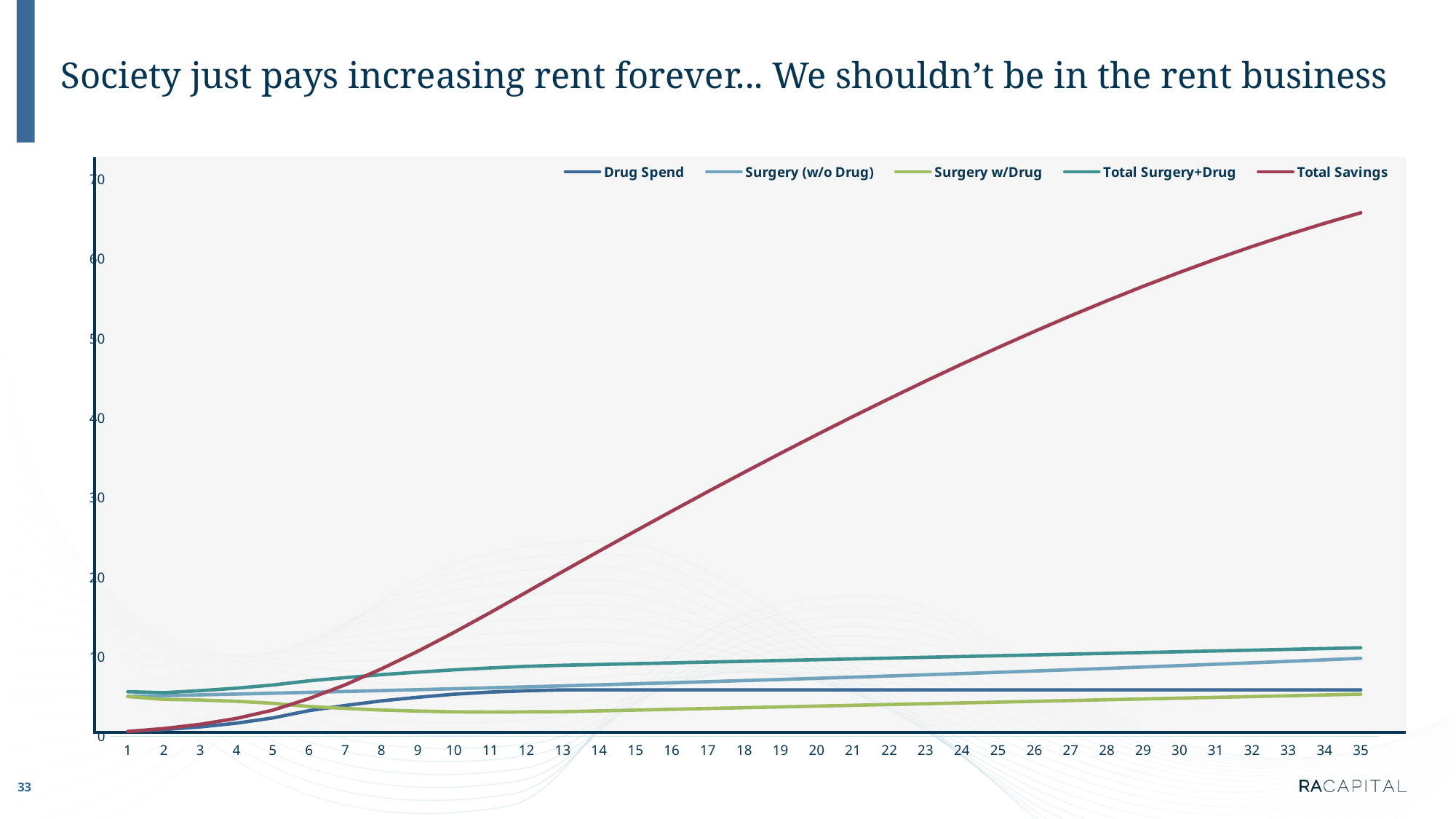
Is the value of Total Savings at point 10 greater or less than 20? less How many points are on the x axis of the chart? 35 Which series has the highest value at point 35? Total Savings How many series does the legend list? 5 At point 35, which is larger: Total Surgery+Drug or Surgery w/Drug? Total Surgery+Drug Is the value of Drug Spend at point 35 greater or less than 10? less What kind of chart is shown on the slide? line chart Does the Total Savings line rise or fall along the x axis? rises At point 20, which is larger: Total Savings or Surgery (w/o Drug)? Total Savings Is the value of Total Savings at point 35 greater or less than 60? greater What colour is the Total Savings line in the legend? red Does the Drug Spend line rise or fall from point 1 to point 35? rises